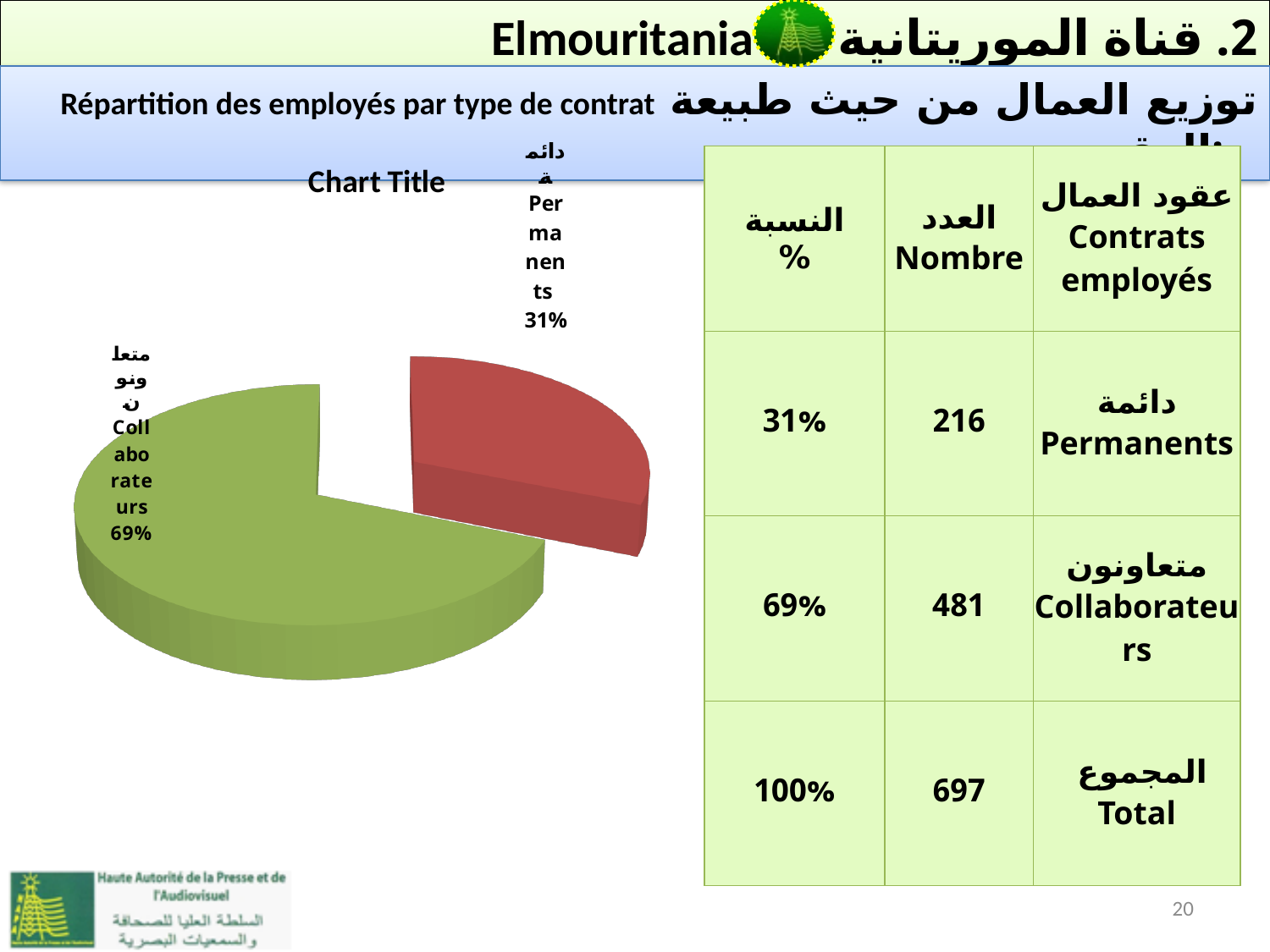
What is the title shown above the pie chart? Chart Title Which is larger, the Permanents slice or the Collaborateurs slice? Collaborateurs What kind of chart is shown on the slide? pie chart What share of the pie does the Permanents slice represent? 31% How many slices does the pie chart have? 2 What colour is the Permanents slice of the pie? red Is the share of the Collaborateurs slice greater or less than 50%? greater What is the difference in percentage points between the Collaborateurs slice and the Permanents slice? 38% Which slice of the pie is the smallest? Permanents Which slice of the pie is the largest? Collaborateurs What share of the pie does the Collaborateurs slice represent? 69%